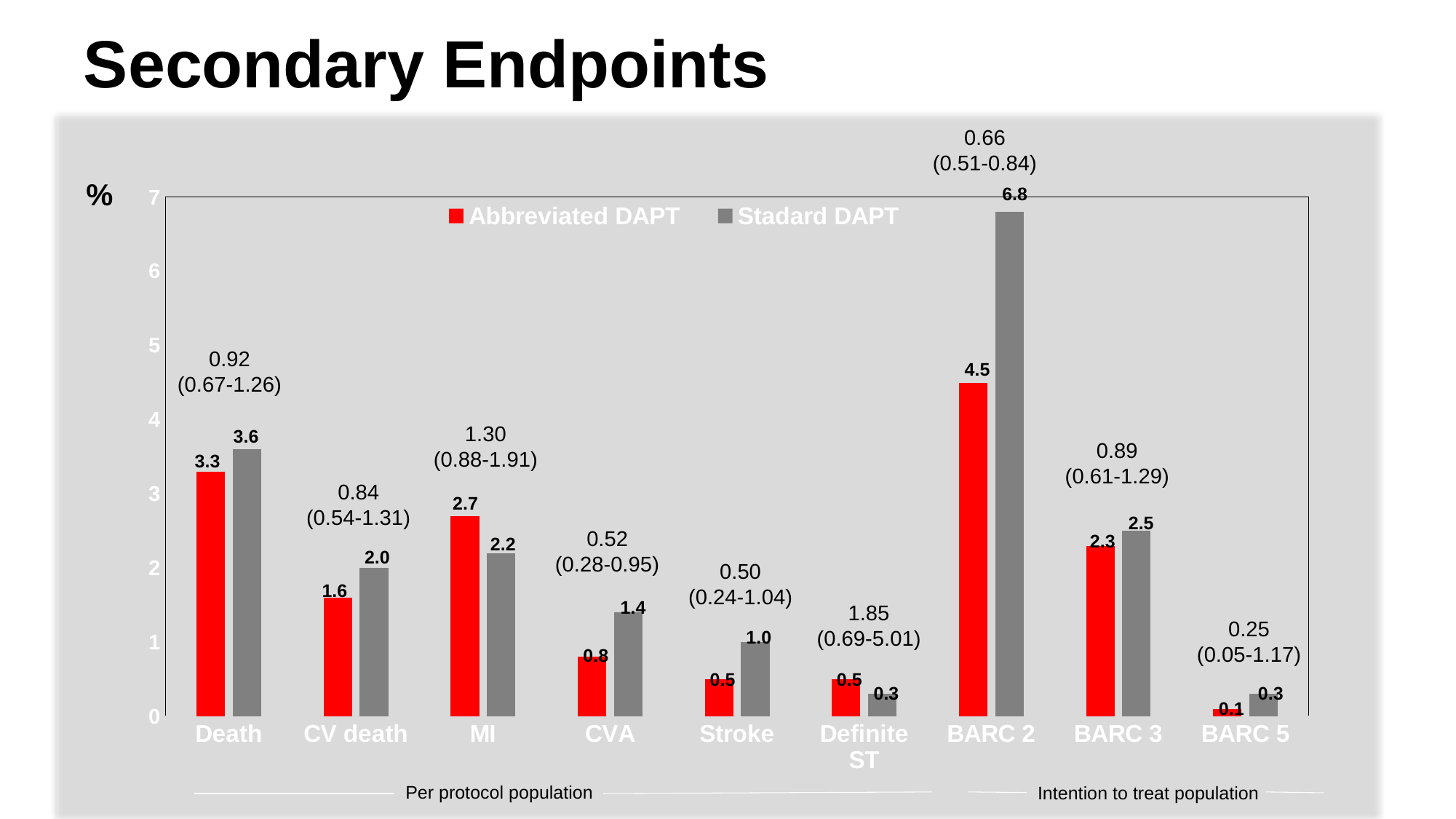
What is the difference between the Abbreviated DAPT and Stadard DAPT values for MI? 0.5 How many categories are shown on the x axis? 9 Which category has the lowest Abbreviated DAPT value? BARC 5 What is the value for Abbreviated DAPT in the Death category? 3.3 What is the value for Abbreviated DAPT in the MI category? 2.7 Which category has the highest Stadard DAPT value? BARC 2 Which is larger for Definite ST: Abbreviated DAPT or Stadard DAPT? Abbreviated DAPT What is the difference between the Stadard DAPT and Abbreviated DAPT values for BARC 2? 2.3 Which is larger for CV death: Abbreviated DAPT or Stadard DAPT? Stadard DAPT What kind of chart is shown on the slide? Bar chart What is the value for Stadard DAPT in the BARC 2 category? 6.8 How many series does the legend list? 2